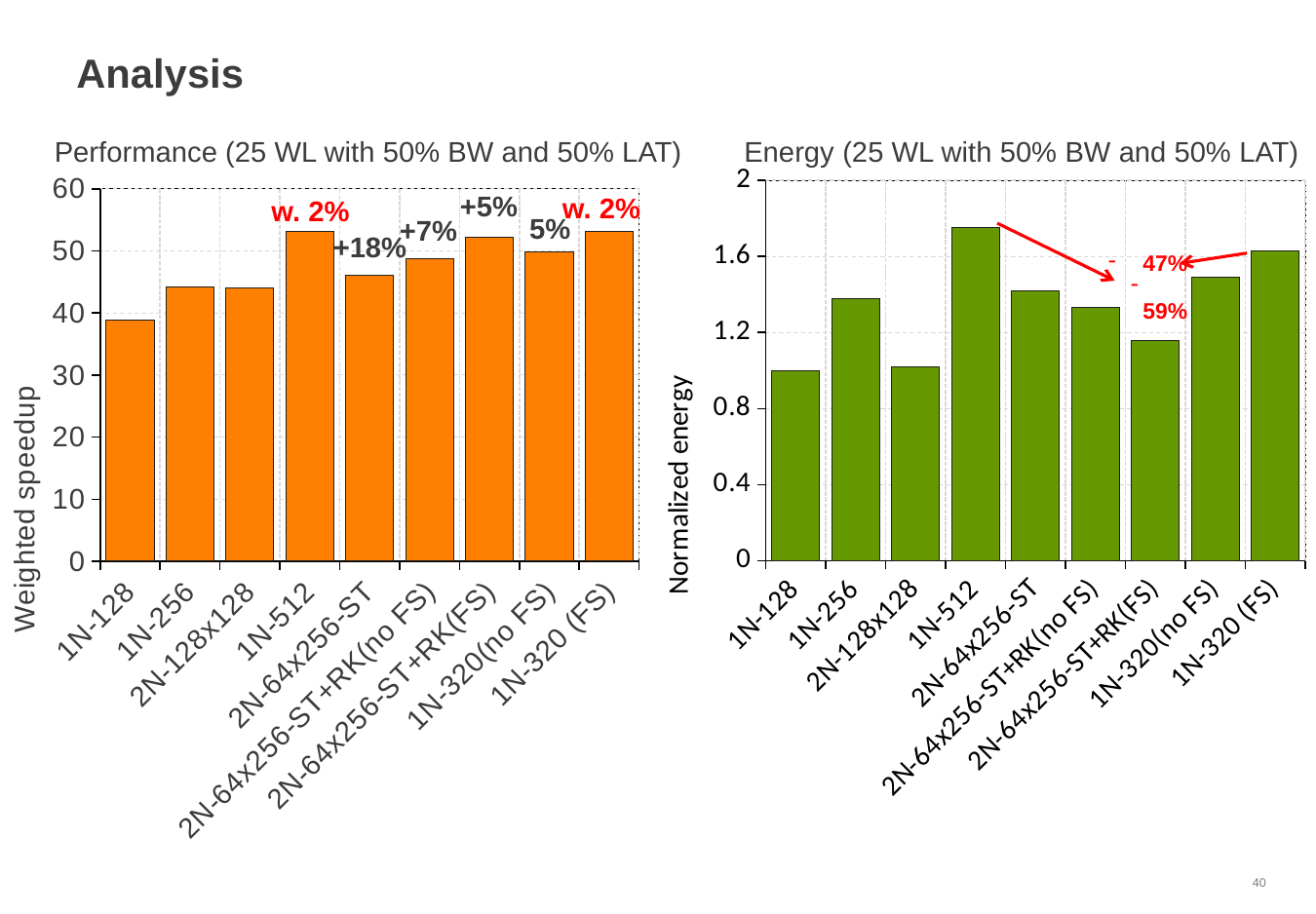
In the Performance chart on the left, which category has the lowest weighted speedup? 1N-128 In the Performance chart on the left, is the value for 1N-128 greater or less than 40? less In the Performance chart on the left, which is larger, the value for 1N-512 or the value for 2N-64x256-ST? 1N-512 In the Energy chart on the right, which is larger, the value for 1N-256 or the value for 2N-128x128? 1N-256 What is the y-axis label of the Energy chart on the right? Normalized energy What kind of chart is the Performance chart on the left? bar chart In the Energy chart on the right, is the value for 2N-64x256-ST+RK(FS) greater or less than 1.2? less In the Performance chart on the left, is the value for 2N-64x256-ST greater or less than 50? less In the Energy chart on the right, which category has the highest normalized energy? 1N-512 How many categories are shown on the x axis of the Energy chart on the right? 9